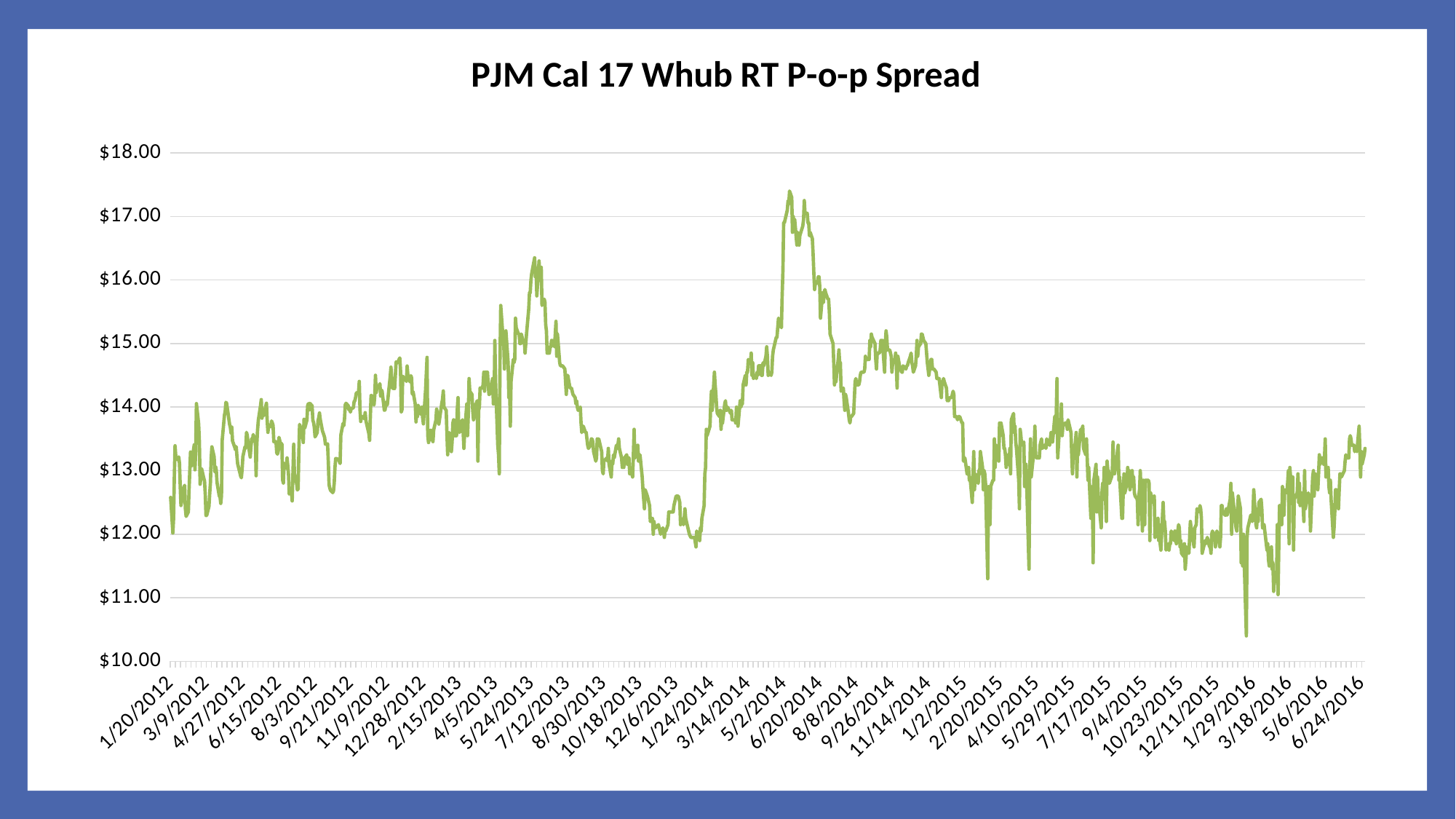
Does the series generally rise or fall between 12/6/2013 and 5/2/2014? rise Is the value at the end of the series, around 6/24/2016, greater or less than $12.00? greater Is the value around 10/23/2015 greater or less than $13.00? less Around which period does the series reach its highest value? between 5/2/2014 and 6/20/2014 Is the lowest dip near 1/29/2016 greater or less than $11.00? less What is the highest value shown on the vertical axis? $18.00 What kind of chart is shown on the slide? line chart Around which date does the series reach its lowest value? around 1/29/2016 What is the title of the chart? PJM Cal 17 Whub RT P-o-p Spread